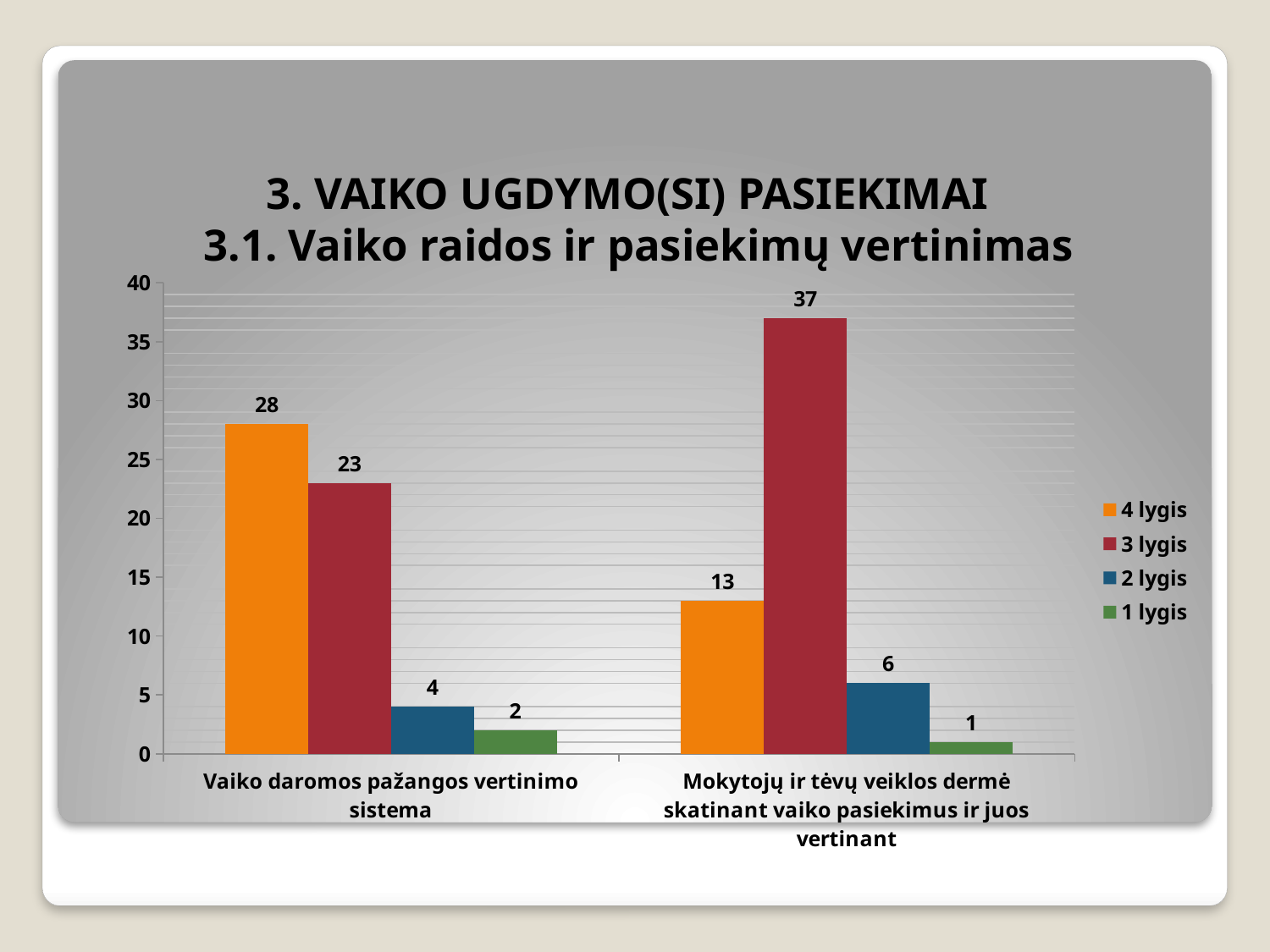
Which is larger: the "4 lygis" value for "Vaiko daromos pažangos vertinimo sistema" or the "4 lygis" value for "Mokytojų ir tėvų veiklos dermė skatinant vaiko pasiekimus ir juos vertinant"? Vaiko daromos pažangos vertinimo sistema What is the difference between the "4 lygis" and "3 lygis" values in the "Vaiko daromos pažangos vertinimo sistema" category? 5 How many series does the legend list? 4 What is the value for "3 lygis" in the "Mokytojų ir tėvų veiklos dermė skatinant vaiko pasiekimus ir juos vertinant" category? 37 What kind of chart is shown on the slide? Bar chart How many categories are shown on the x axis? 2 What is the value for "2 lygis" in the "Mokytojų ir tėvų veiklos dermė skatinant vaiko pasiekimus ir juos vertinant" category? 6 Which series has the highest value in the "Mokytojų ir tėvų veiklos dermė skatinant vaiko pasiekimus ir juos vertinant" category? 3 lygis Which series has the lowest value in the "Vaiko daromos pažangos vertinimo sistema" category? 1 lygis What is the value for "1 lygis" in the "Vaiko daromos pažangos vertinimo sistema" category? 2 What is the value for "4 lygis" in the "Vaiko daromos pažangos vertinimo sistema" category? 28 What is the difference between the "3 lygis" values of the two categories? 14